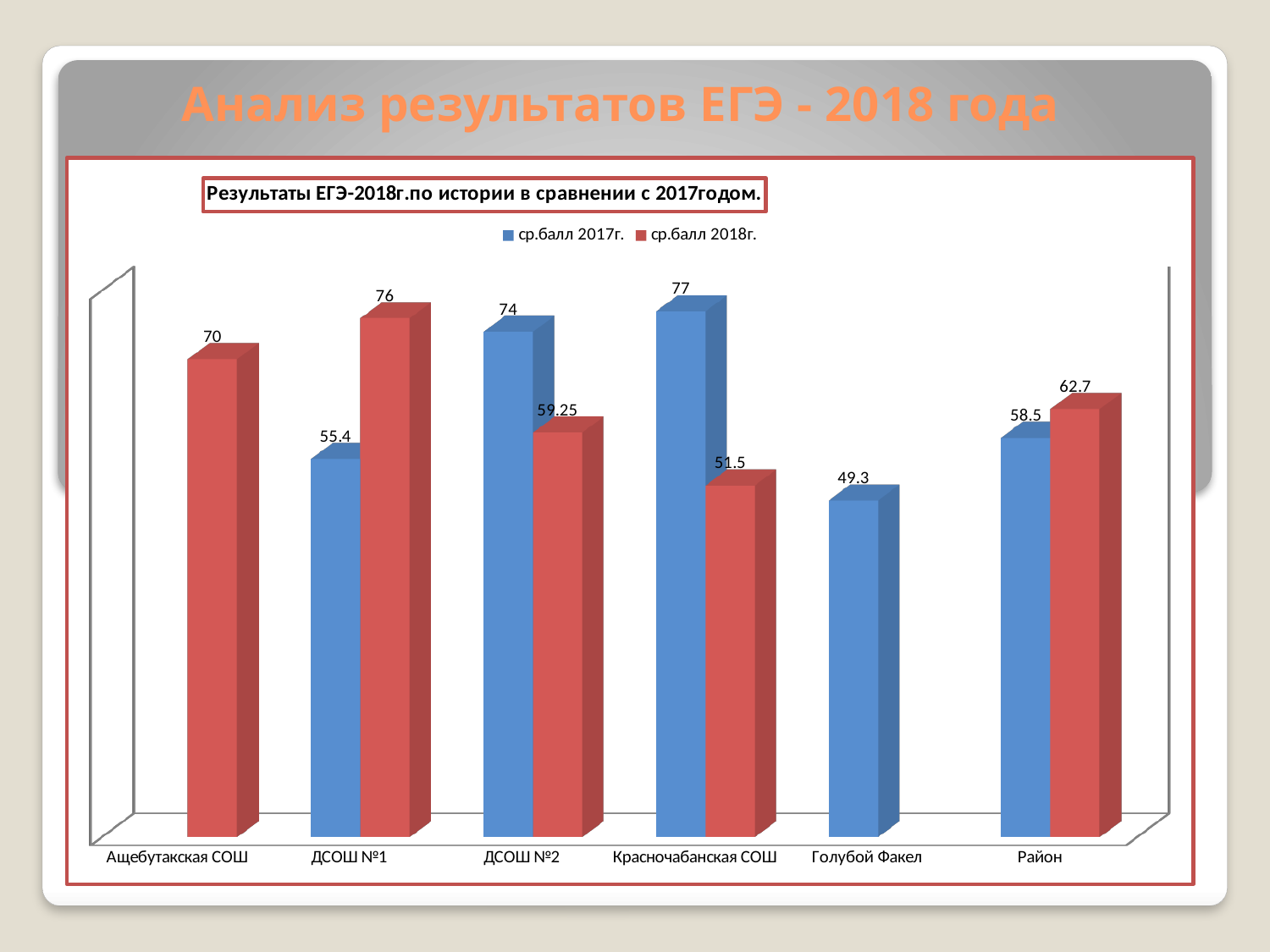
How many categories are shown on the x axis? 6 What kind of chart is shown on the slide? Bar chart What is the ср.балл 2018г. value for Ащебутакская СОШ? 70 For Район, which is larger: ср.балл 2017г. or ср.балл 2018г.? ср.балл 2018г. What is the ср.балл 2017г. value for Голубой Факел? 49.3 Which category has the highest ср.балл 2017г. value? Красночабанская СОШ What is the title of the chart? Результаты ЕГЭ-2018г.по истории в сравнении с 2017годом. Which category has the lowest ср.балл 2018г. value? Красночабанская СОШ What is the ср.балл 2018г. value for ДСОШ №2? 59.25 What is the ср.балл 2017г. value for ДСОШ №1? 55.4 How many series does the legend list? 2 What is the difference between the ср.балл 2018г. and ср.балл 2017г. values for ДСОШ №1? 20.6